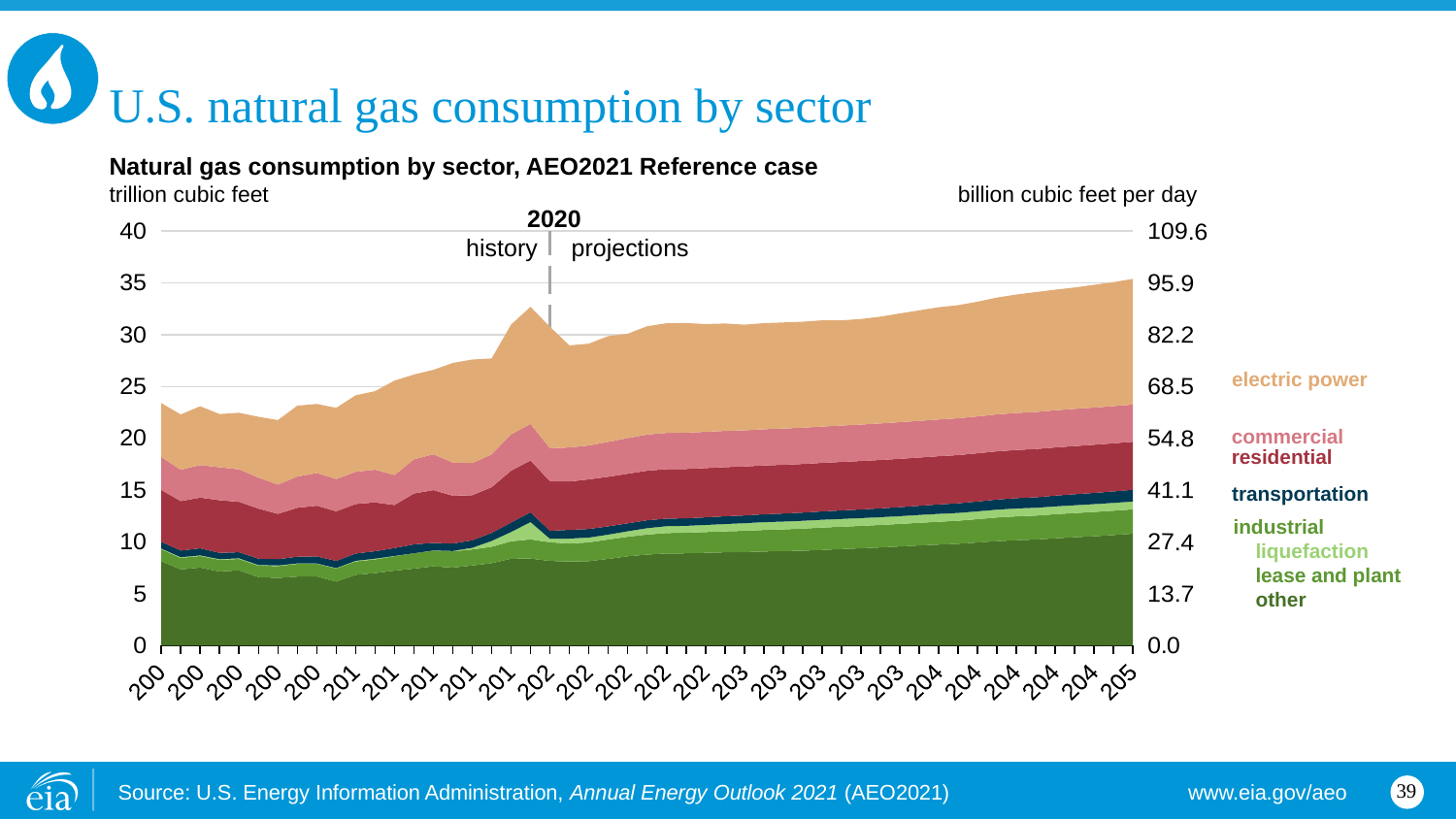
Is the total natural gas consumption at the right end of the chart greater or less than 30 trillion cubic feet? greater Which sector is plotted as the top layer of the stacked area chart? electric power Does total natural gas consumption rise or fall over the projection period after 2020? rise What is the highest value shown on the right axis (billion cubic feet per day)? 109.6 What is the title of the chart? Natural gas consumption by sector, AEO2021 Reference case In which year does the chart switch from history to projections? 2020 What kind of chart is shown on the slide? stacked area chart Is the total natural gas consumption at the left end of the chart greater or less than 25 trillion cubic feet? less What unit is shown on the left axis of the chart? trillion cubic feet Is the electric power sector's consumption at the right end of the chart greater or less than 5 trillion cubic feet? greater What is the highest value shown on the left axis? 40